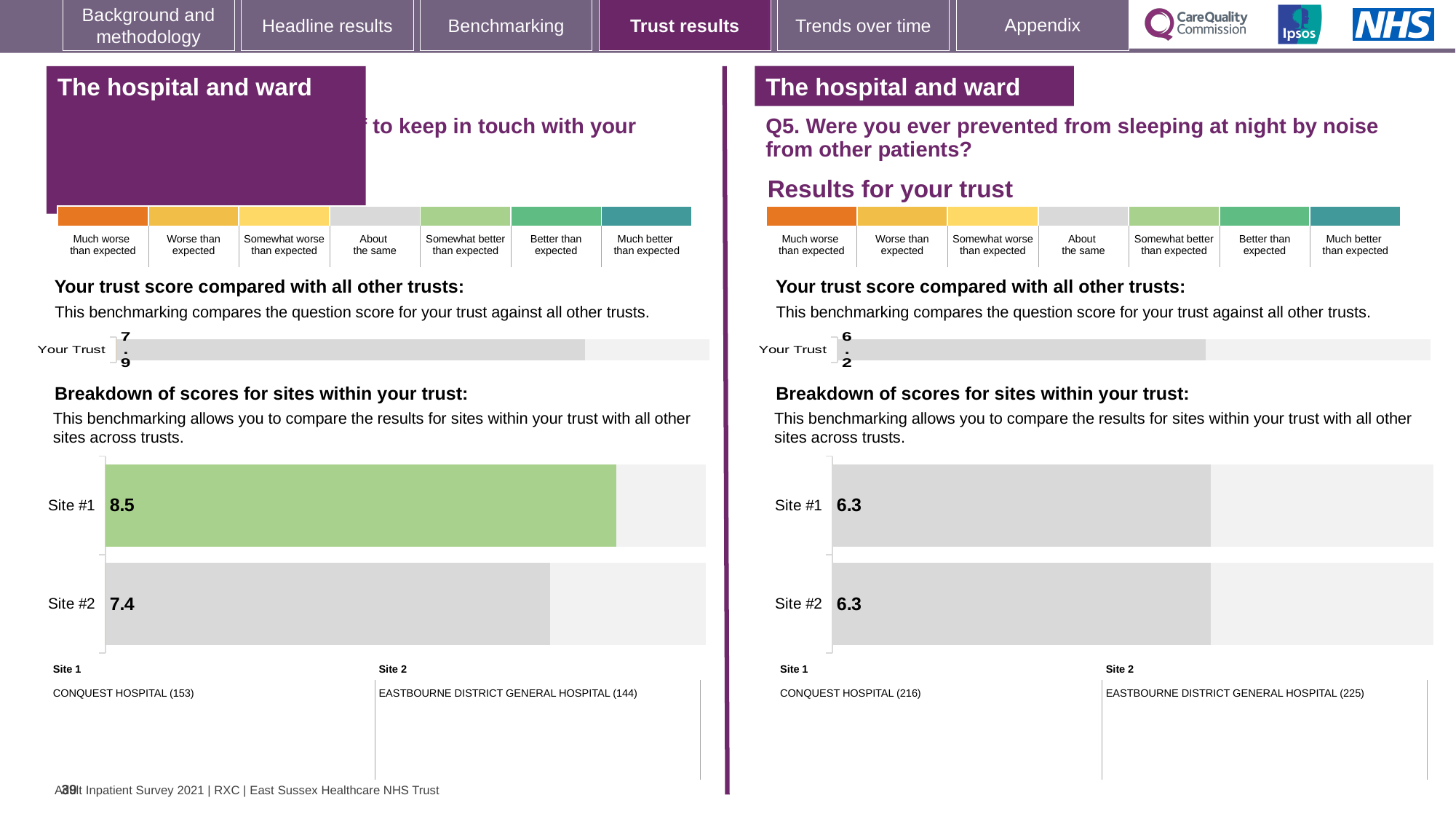
On the left-hand chart, which site has the higher score? Site #1 On the right-hand chart (Q5), what is the difference between the Site #1 and Site #2 scores? 0 On the left-hand chart, what is the score for Site #2? 7.4 What type of chart is used for the breakdown of scores for sites on the left-hand side? Bar chart How many sites are shown in the site breakdown chart on the right-hand side (Q5)? 2 On the left-hand chart, what is the 'Your Trust' score? 7.9 On the left-hand chart, what is the score for Site #1? 8.5 On the left-hand chart, what is the difference between the Site #1 and Site #2 scores? 1.1 On the right-hand chart (Q5), what is the score for Site #2? 6.3 On the right-hand chart (Q5, prevented from sleeping by noise from other patients), what is the score for Site #1? 6.3 On the right-hand chart (Q5), what is the 'Your Trust' score? 6.2 On the left-hand chart, which benchmark category does the colour of the Site #1 bar correspond to? Somewhat better than expected